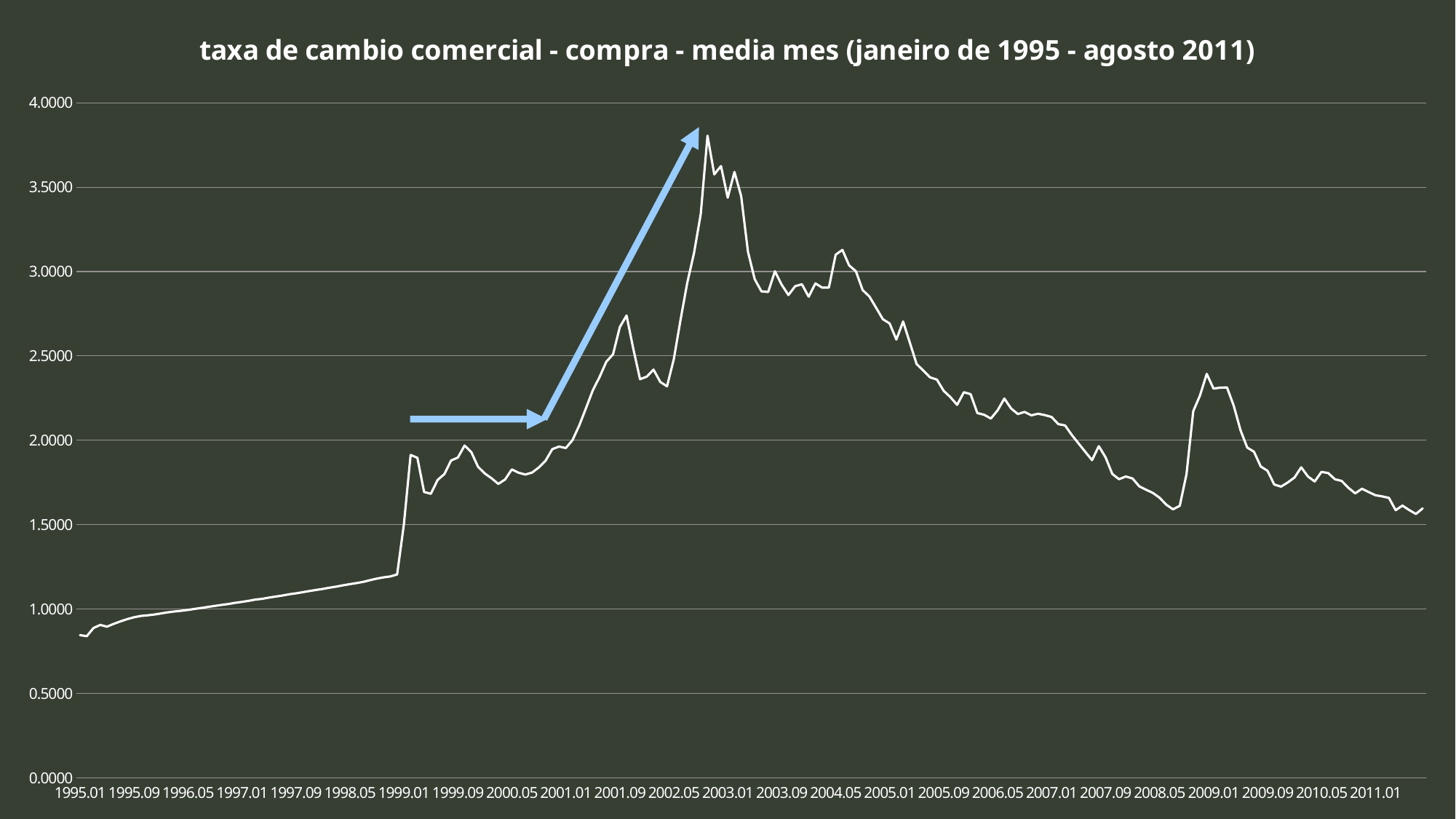
Is the value at 1995.01 greater or less than 1.0000? less In which year does the line reach its highest point? 2002 Is the value at 2007.01 greater or less than 2.0000? greater Is the value at 2008.05 greater or less than 2.0000? less What is the title of the chart? taxa de cambio comercial - compra - media mes (janeiro de 1995 - agosto 2011) What kind of chart is shown on the slide? line chart Does the line rise or fall between 1995.01 and 1999.01? rise What colour are the two arrows drawn on the chart? light blue